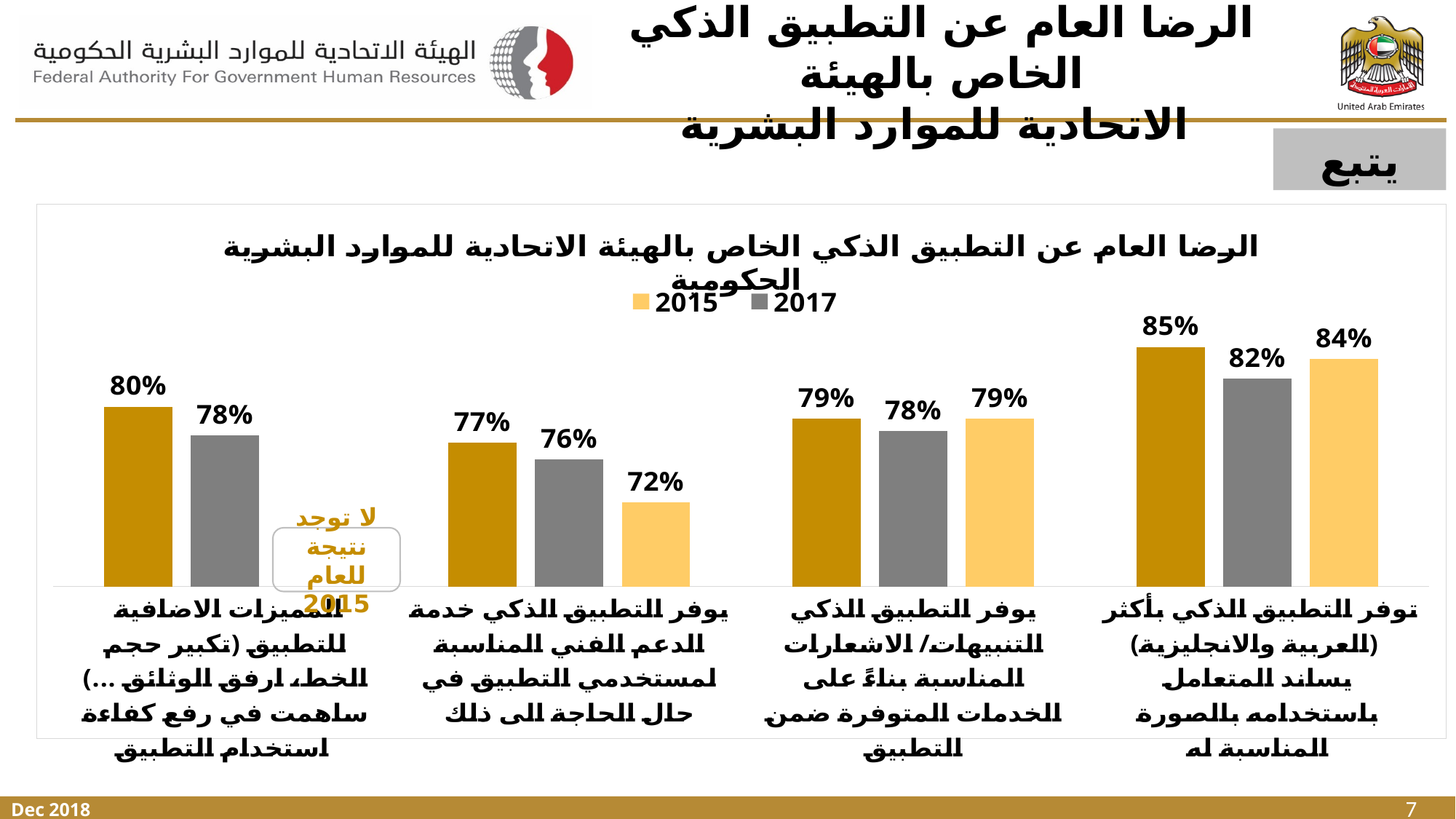
Which category has the lowest 2015 value? يوفر التطبيق الذكي خدمة الدعم الفني المناسبة لمستخدمي التطبيق في حال الحاجة الى ذلك Which category has no 2015 result shown on the chart? المميزات الاضافية للتطبيق (تكبير حجم الخط، ارفق الوثائق ...) ساهمت في رفع كفاءة استخدام التطبيق What is the 2017 value for the category "توفر التطبيق الذكي بأكثر (العربية والانجليزية) يساند المتعامل باستخدامه بالصورة المناسبة له"? 82% How many series does the chart legend list? 2 Which category has the highest 2017 value? توفر التطبيق الذكي بأكثر (العربية والانجليزية) يساند المتعامل باستخدامه بالصورة المناسبة له How many categories are shown along the x axis of the chart? 4 What is the difference between the 2015 and 2017 values for the category "توفر التطبيق الذكي بأكثر (العربية والانجليزية) يساند المتعامل باستخدامه بالصورة المناسبة له"? 2% For the category "يوفر التطبيق الذكي خدمة الدعم الفني المناسبة لمستخدمي التطبيق في حال الحاجة الى ذلك", which is larger: the 2015 value or the 2017 value? 2017 What is the 2015 value for the category "يوفر التطبيق الذكي التنبيهات/ الاشعارات المناسبة بناءً على الخدمات المتوفرة ضمن التطبيق"? 79% What is the 2017 value for the category "المميزات الاضافية للتطبيق (تكبير حجم الخط، ارفق الوثائق ...) ساهمت في رفع كفاءة استخدام التطبيق"? 78% What type of chart is shown on the slide? Bar chart What is the 2015 value for the category "يوفر التطبيق الذكي خدمة الدعم الفني المناسبة لمستخدمي التطبيق في حال الحاجة الى ذلك"? 72%